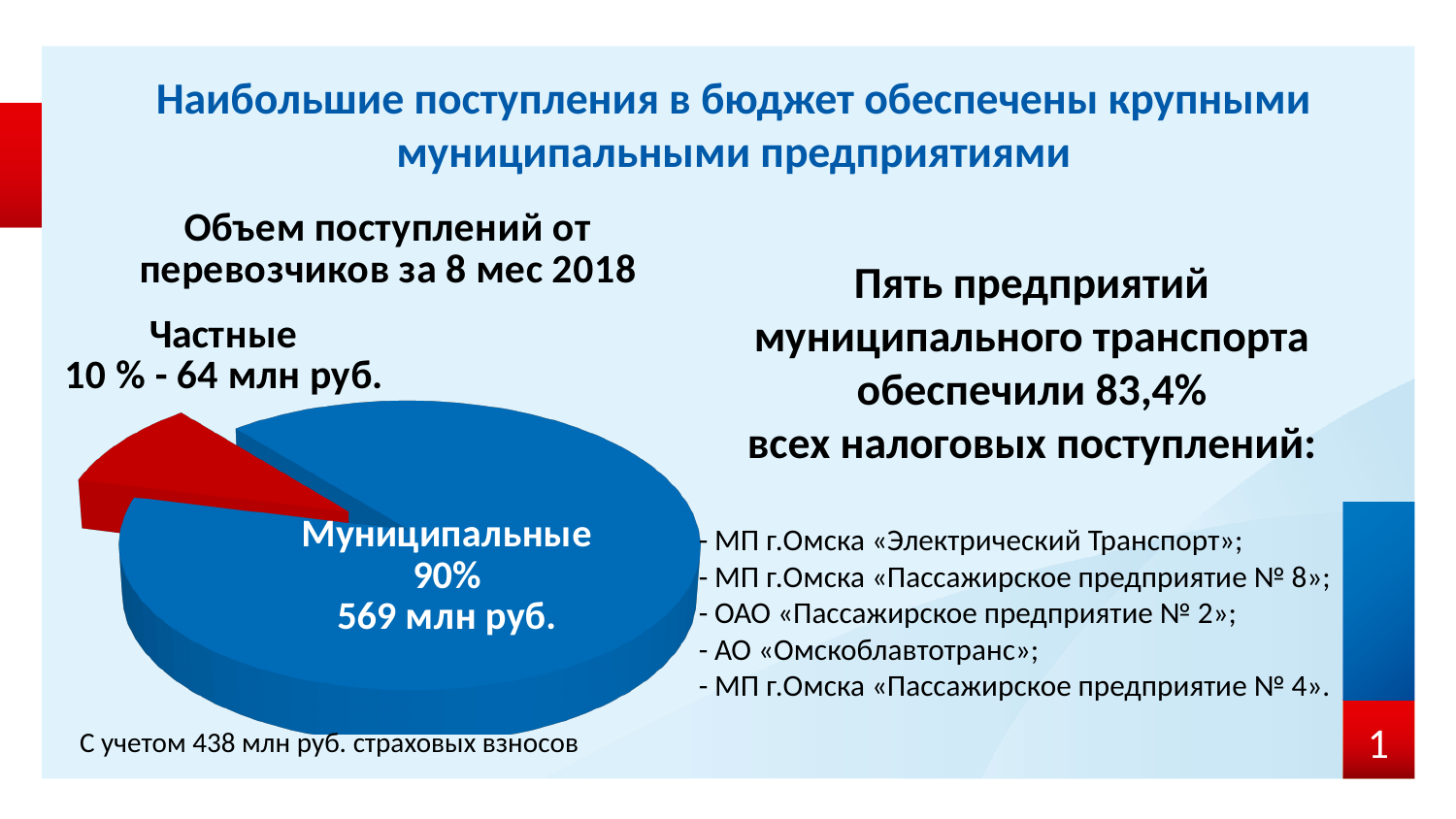
Which slice of the pie chart is the smallest? Частные What colour is the Частные slice in the pie chart? Red What is the title of the pie chart? Объем поступлений от перевозчиков за 8 мес 2018 What type of chart is shown on the slide? Pie chart What is the value shown for Муниципальные in the pie chart? 569 млн руб. Which is larger, the value for Частные or the value for Муниципальные? Муниципальные What is the difference in млн руб. between the Муниципальные and Частные values? 505 млн руб. What share of the pie does the Муниципальные slice represent? 90% Which slice of the pie chart is the largest? Муниципальные How many slices does the pie chart have? 2 What is the value shown for Частные in the pie chart? 64 млн руб. What share of the pie does the Частные slice represent? 10 %